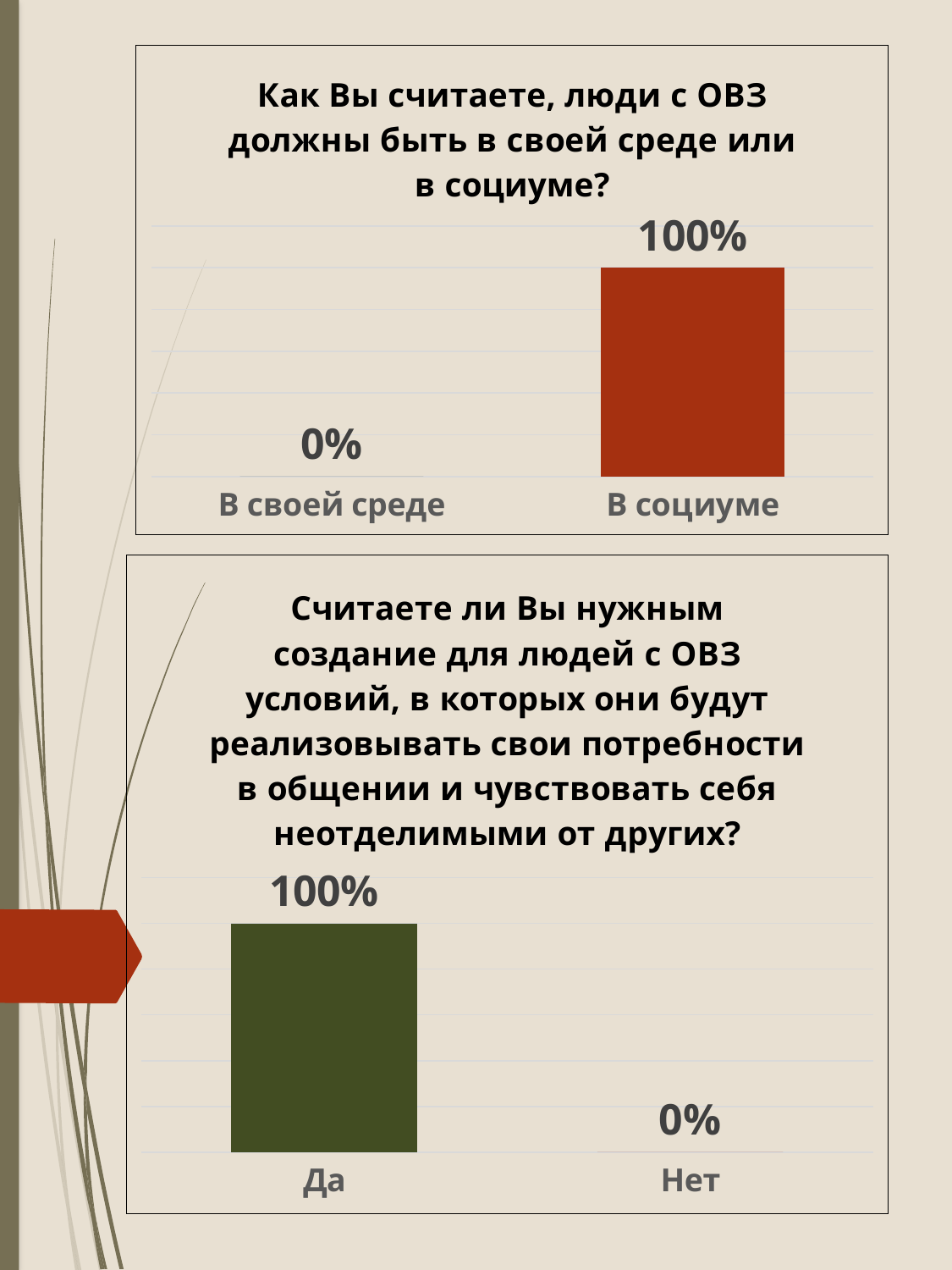
In the bottom chart, what is the value for 'Да'? 100% What kind of chart is the bottom chart? Bar chart In the bottom chart, which is larger, the value for 'Да' or the value for 'Нет'? Да In the top chart, what is the value for 'В социуме'? 100% In the top chart, which category has the highest value? В социуме In the top chart, how many categories are shown? 2 In the bottom chart, which category has the highest value? Да In the top chart, what is the value for 'В своей среде'? 0% In the top chart, which category has the lowest value? В своей среде In the bottom chart, what is the value for 'Нет'? 0% In the top chart, what is the difference between the values for 'В социуме' and 'В своей среде'? 100% What colour is the bar for 'Да' in the bottom chart? Dark green